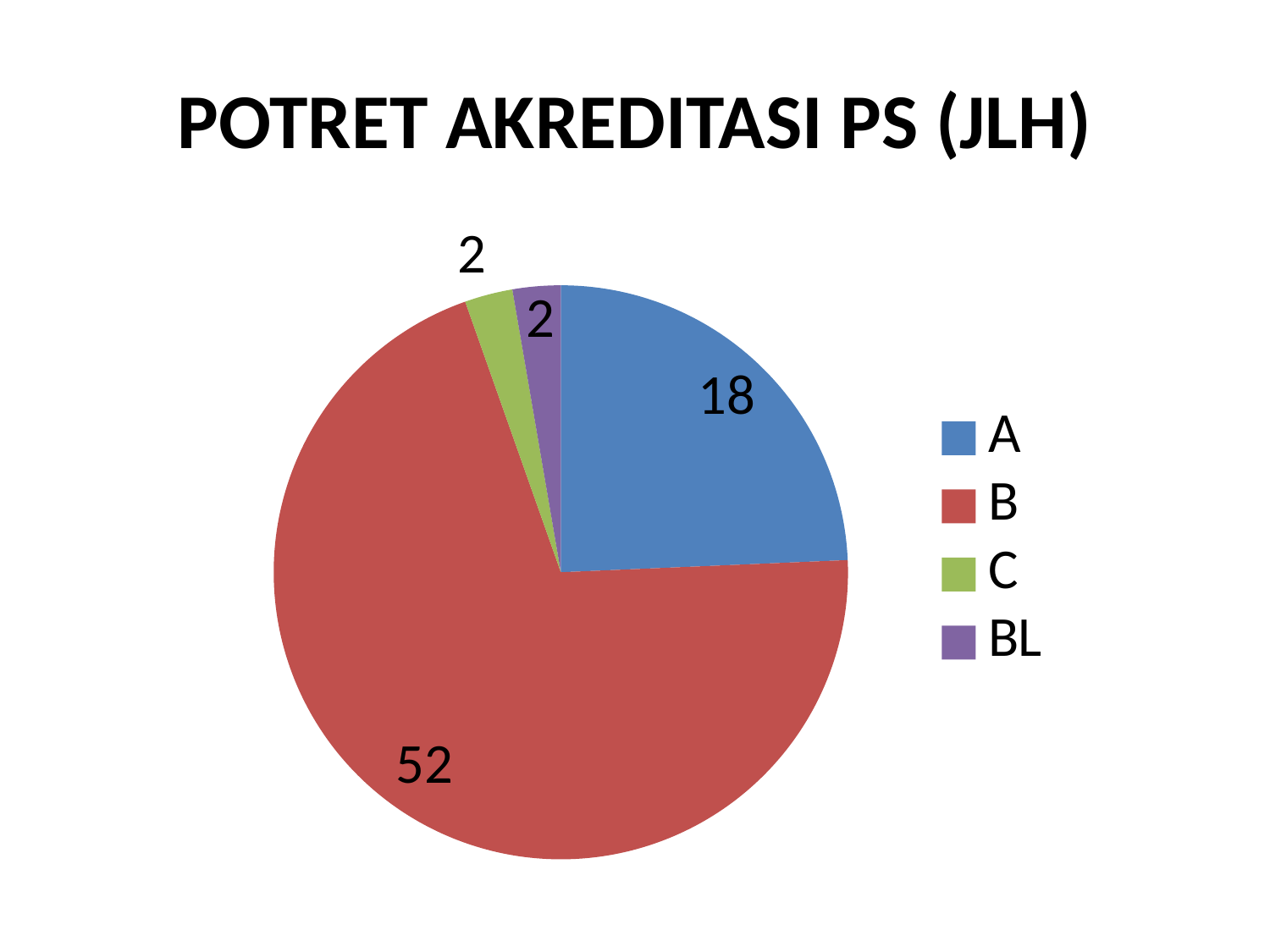
What is the difference between the values for A and C? 16 How many categories does the pie chart show? 4 Which is larger, the value for A or the value for B? B What is the title of the chart on the slide? POTRET AKREDITASI PS (JLH) What is the value for category BL in the pie chart? 2 What is the difference between the values for B and A? 34 What is the value for category C in the pie chart? 2 What kind of chart is shown on the slide? pie chart What is the value for category B in the pie chart? 52 What is the value for category A in the pie chart? 18 Which category has the largest slice in the pie chart? B What is the total of all the slices in the pie chart? 74